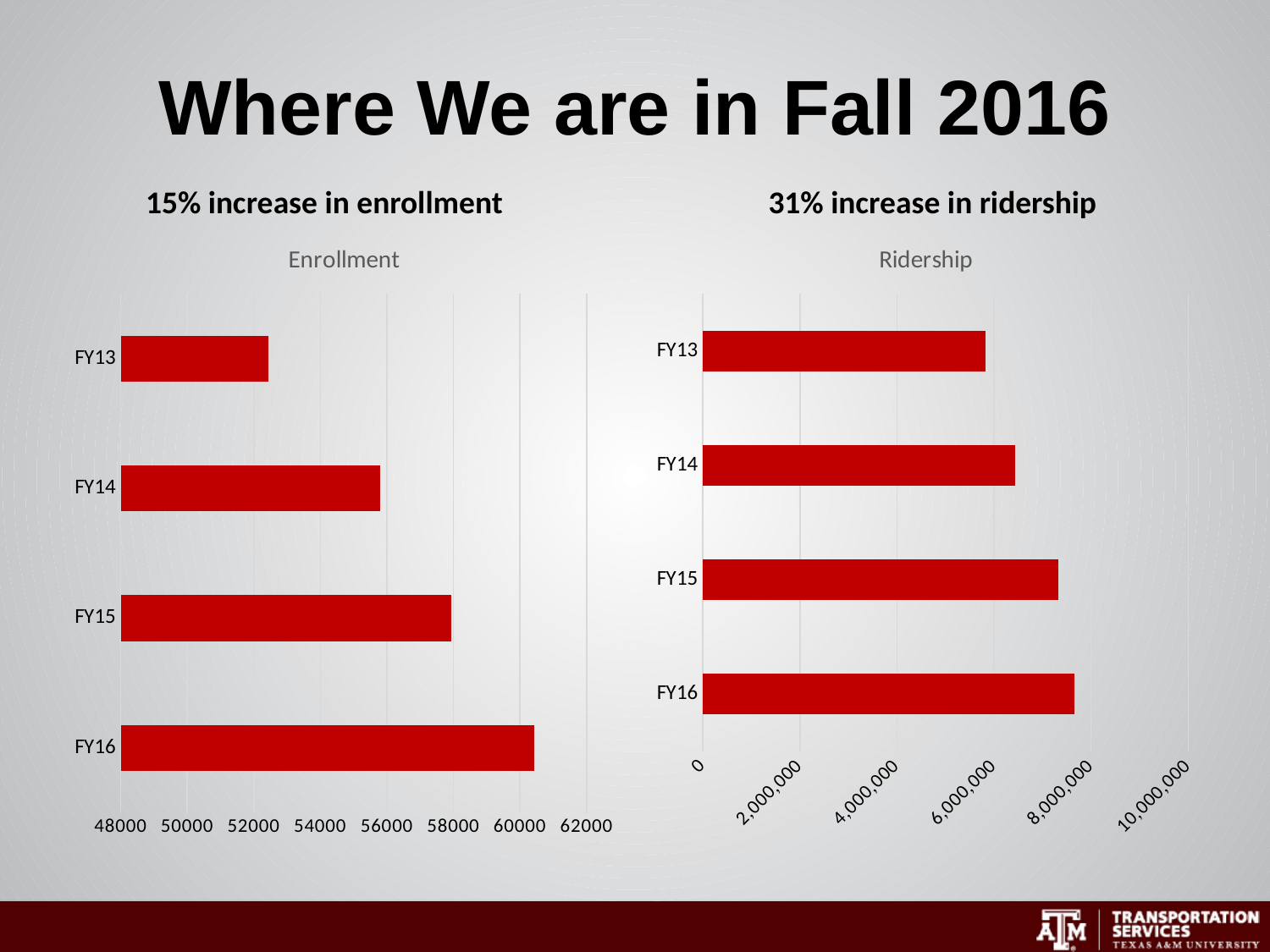
How many fiscal years are shown in the Enrollment chart? 4 In the Enrollment chart, which fiscal year has the lowest enrollment? FY13 In the Enrollment chart, is the value for FY14 greater or less than 54000? greater In the Ridership chart, does ridership rise or fall from FY13 to FY16? rise In the Ridership chart, which fiscal year has the highest ridership? FY16 In the Enrollment chart, is the value for FY16 greater or less than 58000? greater In the Enrollment chart, is the value for FY13 greater or less than 54000? less In the Ridership chart, which is larger, the value for FY14 or the value for FY16? FY16 In the Ridership chart, which fiscal year has the lowest ridership? FY13 In the Enrollment chart, which fiscal year has the highest enrollment? FY16 What type of chart is the Enrollment chart? bar chart